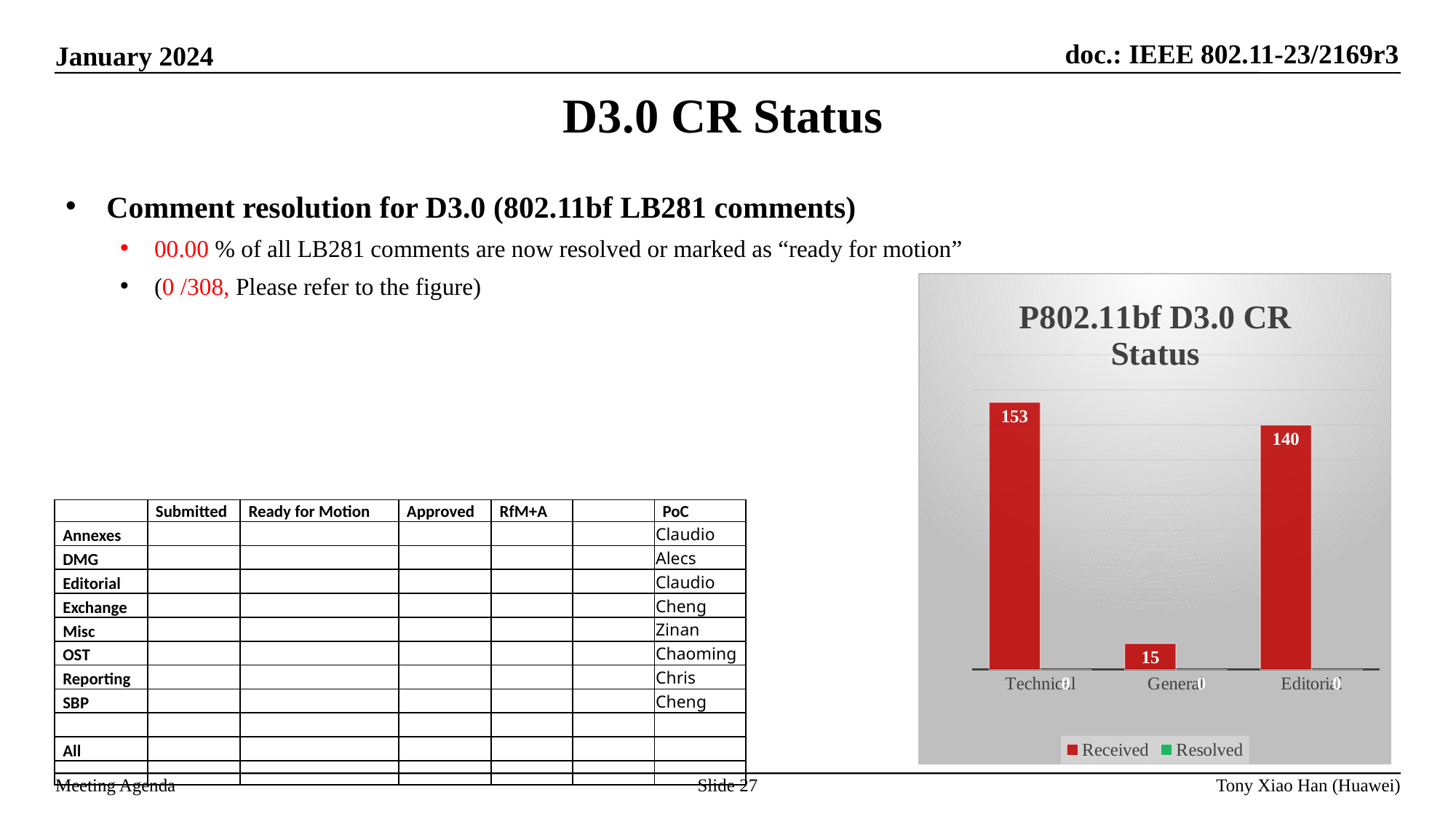
How many series does the legend of the P802.11bf D3.0 CR Status chart list? 2 What are the two series named in the legend of the P802.11bf D3.0 CR Status chart? Received and Resolved How many categories are shown on the x axis of the P802.11bf D3.0 CR Status chart? 3 What is the difference between the Received values for Editorial and General in the P802.11bf D3.0 CR Status chart? 125 What is the Received value for Technical in the P802.11bf D3.0 CR Status chart? 153 In the P802.11bf D3.0 CR Status chart, is the Received value larger for Technical or for General? Technical What kind of chart is the P802.11bf D3.0 CR Status chart? Bar chart What is the Received value for Editorial in the P802.11bf D3.0 CR Status chart? 140 Which category has the lowest Received value in the P802.11bf D3.0 CR Status chart? General Which category has the highest Received value in the P802.11bf D3.0 CR Status chart? Technical What is the difference between the Received values for Technical and Editorial in the P802.11bf D3.0 CR Status chart? 13 What is the Received value for General in the P802.11bf D3.0 CR Status chart? 15